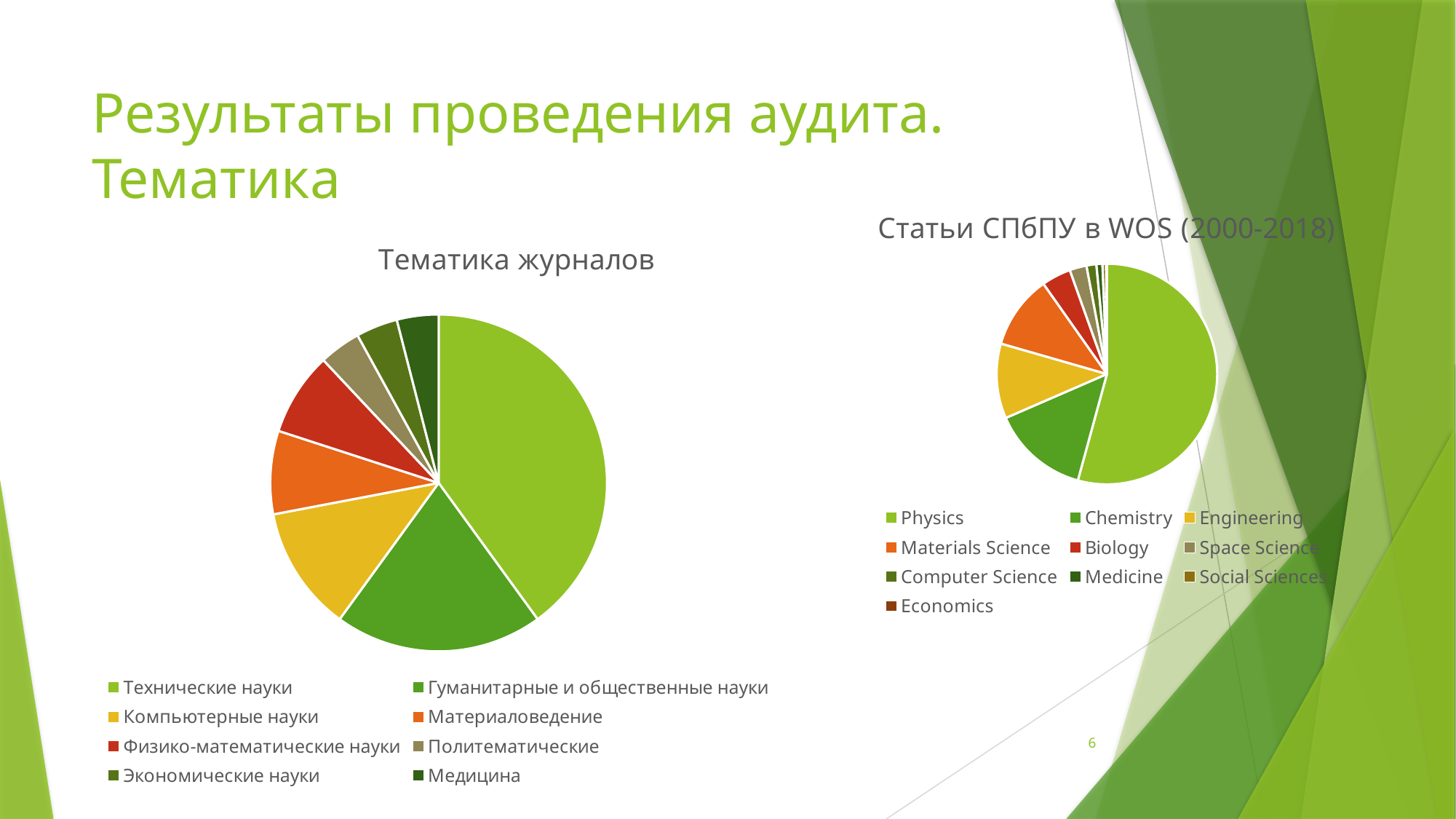
In the chart titled "Статьи СПбПУ в WOS (2000-2018)", which slice is larger: Chemistry or Engineering? Chemistry What is the title of the pie chart on the right side of the slide? Статьи СПбПУ в WOS (2000-2018) In the chart titled "Тематика журналов", which slice is larger: Компьютерные науки or Физико-математические науки? Компьютерные науки What kind of chart is the chart titled "Тематика журналов"? pie chart What kind of chart is the chart titled "Статьи СПбПУ в WOS (2000-2018)"? pie chart In the chart titled "Тематика журналов", how many categories does the legend list? 8 In the chart titled "Статьи СПбПУ в WOS (2000-2018)", which category has the largest slice? Physics In the chart titled "Тематика журналов", which category is shown in the yellow colour? Компьютерные науки In the chart titled "Статьи СПбПУ в WOS (2000-2018)", how many categories does the legend list? 10 In the chart titled "Тематика журналов", which slice is larger: Технические науки or Гуманитарные и общественные науки? Технические науки In the chart titled "Тематика журналов", which category has the largest slice? Технические науки